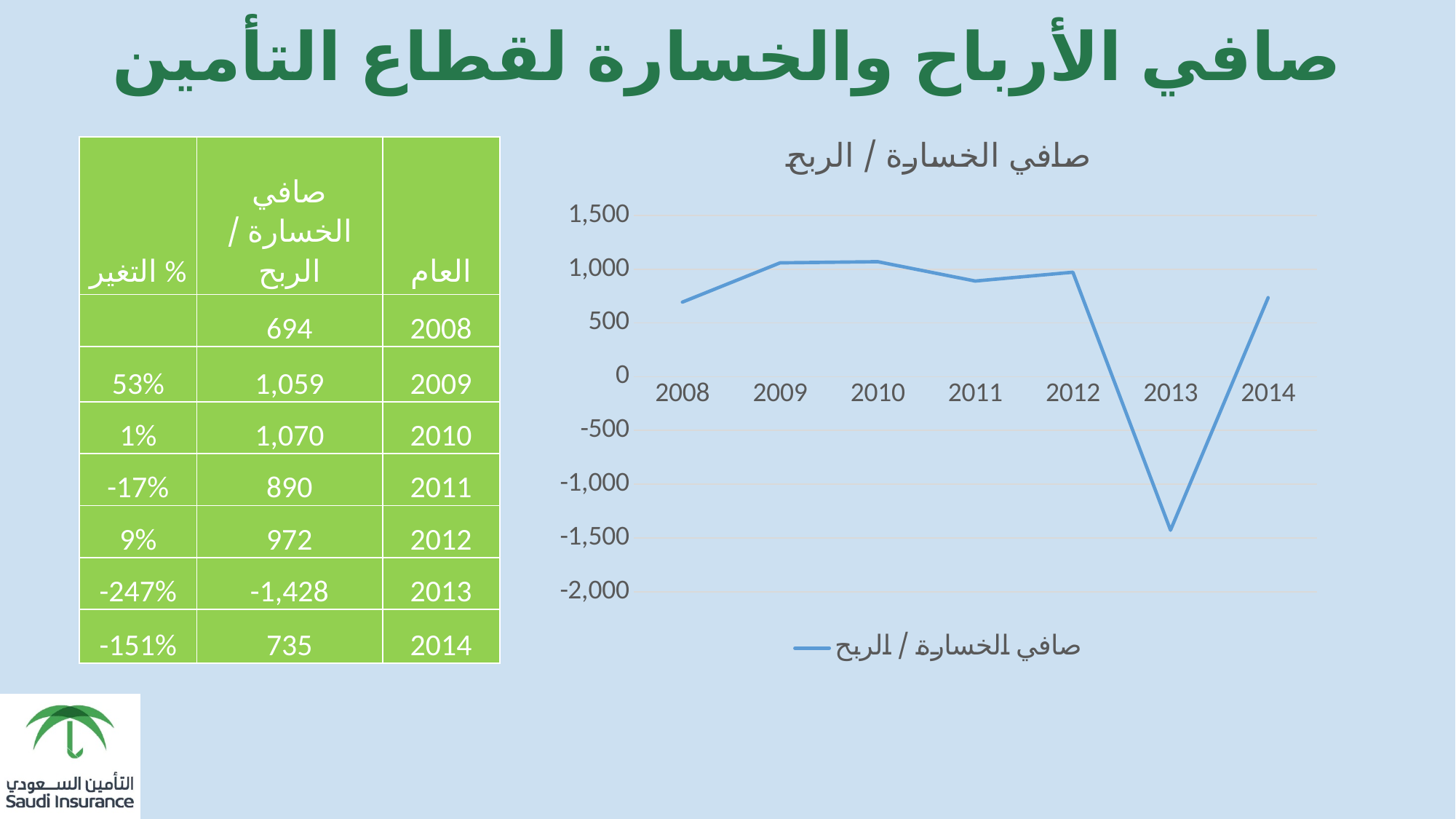
What kind of chart is shown on the slide? line chart Which year has the lowest value on the chart? 2013 Is the value for 2008 on the chart greater or less than 500? greater According to the slide, what is the net profit/loss value for 2010? 1,070 How many series does the chart's legend list? 1 Does the line on the chart rise or fall from 2012 to 2013? fall Is the value for 2013 on the chart greater or less than -1,000? less Which year has the larger value on the chart, 2011 or 2012? 2012 How many years are plotted along the x axis of the chart? 7 According to the slide, what is the net profit/loss value for 2013? -1,428 What is the lowest tick value shown on the chart's vertical axis? -2,000 Using the values printed on the slide, what is the difference between the 2009 value and the 2008 value? 365